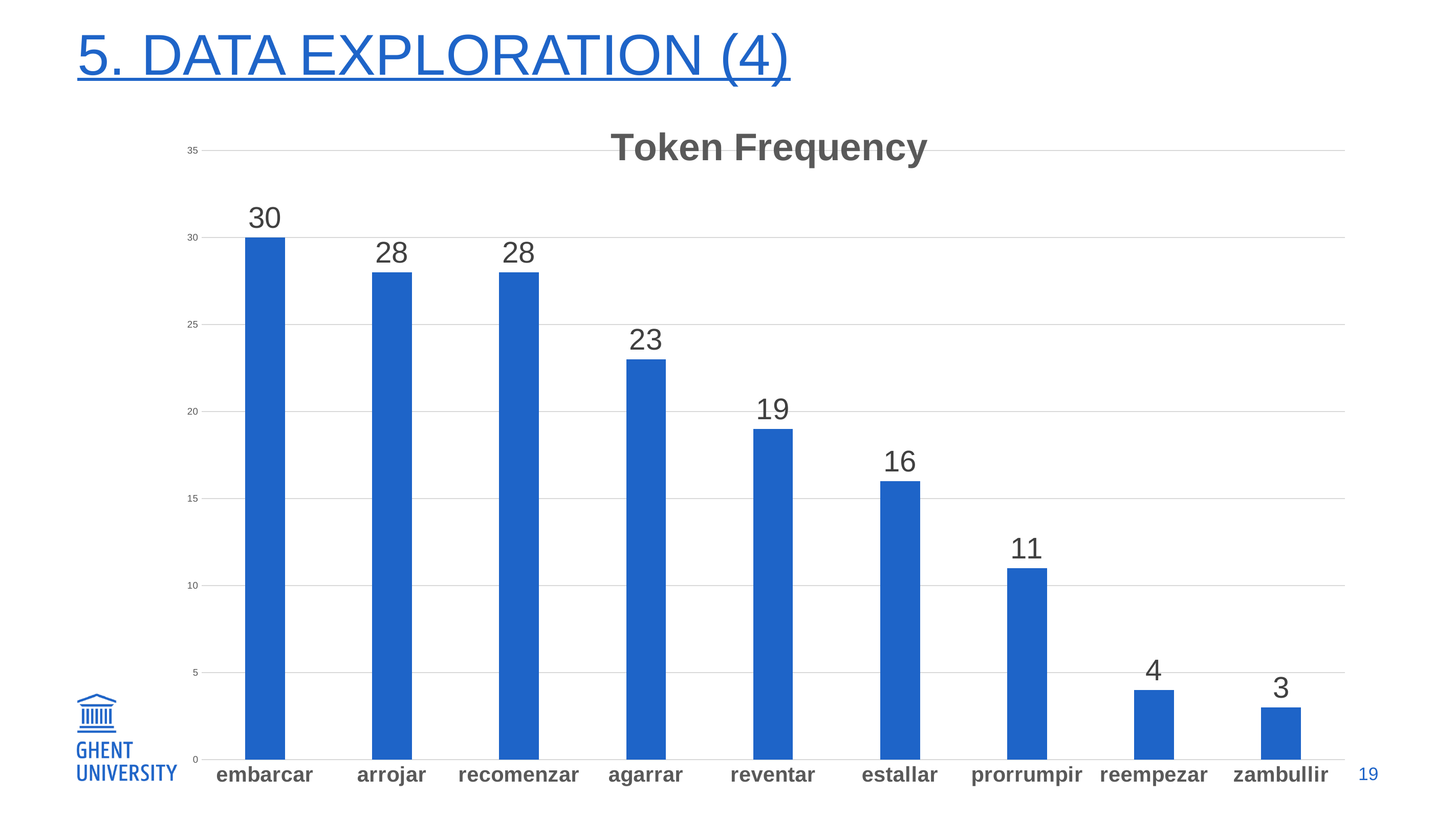
What is the difference in token frequency between estallar and reempezar? 12 Do the token frequencies rise or fall from left to right along the x axis? fall What kind of chart is shown on the slide? bar chart Is the token frequency for reventar greater or less than 15? greater What is the token frequency for prorrumpir? 11 Which verb has the lowest token frequency? zambullir Which has a higher token frequency, agarrar or estallar? agarrar How many verbs are shown on the x axis? 9 Which verb has the highest token frequency? embarcar What is the token frequency for agarrar? 23 What is the difference in token frequency between embarcar and reventar? 11 What is the token frequency for embarcar? 30